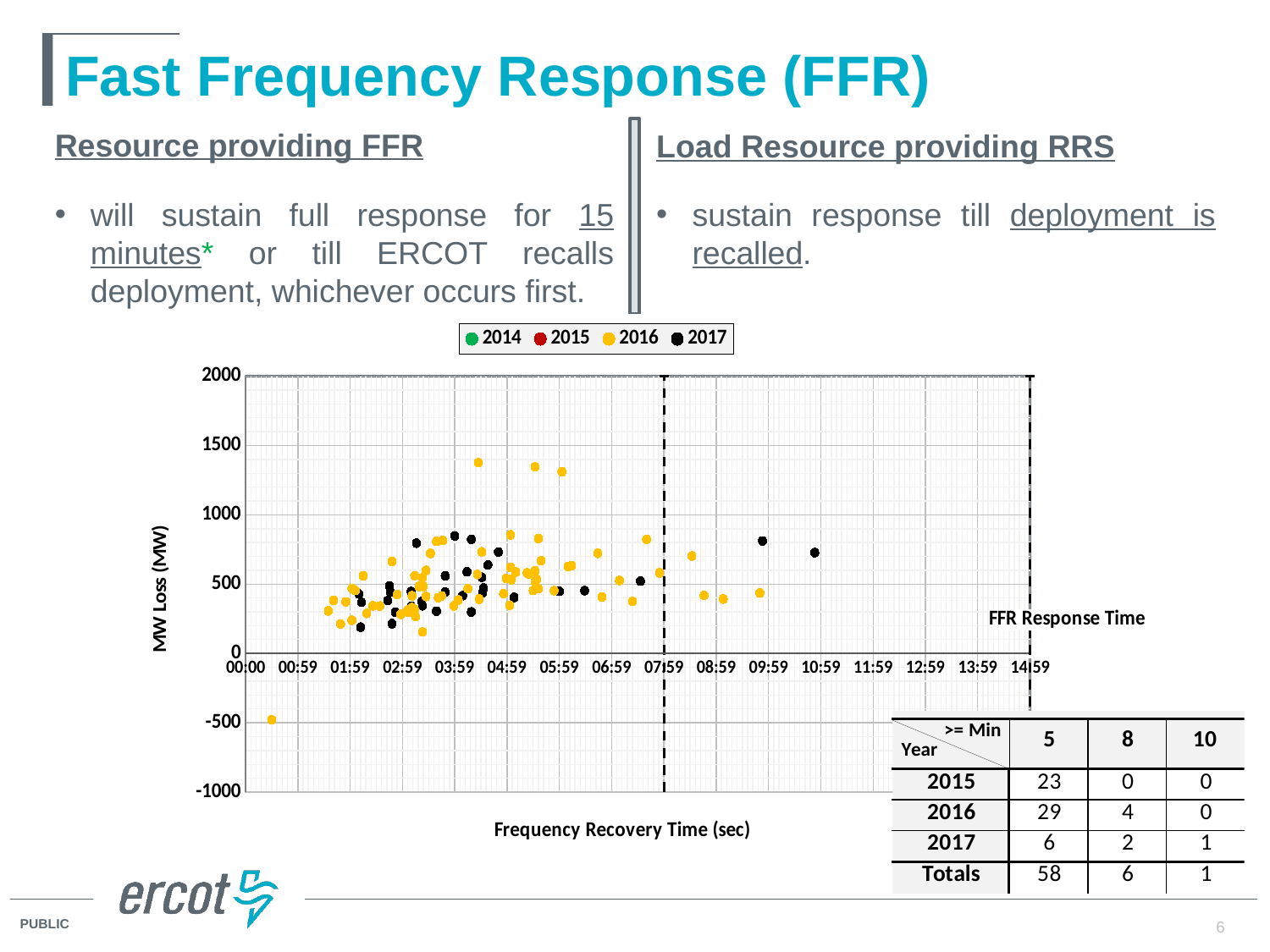
How many tick labels are shown on the chart's x axis? 16 What label is given to the dashed vertical line in the chart? FFR Response Time How many series does the chart legend list? 4 Are any points on the chart plotted above 1500 MW? No Is the lowest MW Loss value plotted on the chart greater or less than 0? less Which series contains the highest MW Loss point on the chart? 2016 What kind of chart is shown on the slide? scatter chart Which series has more points plotted on the chart, 2016 or 2017? 2016 Is the highest MW Loss value plotted on the chart greater or less than 1000? greater What is the title of the chart's y axis? MW Loss (MW) Which series contains the lowest MW Loss point on the chart? 2016